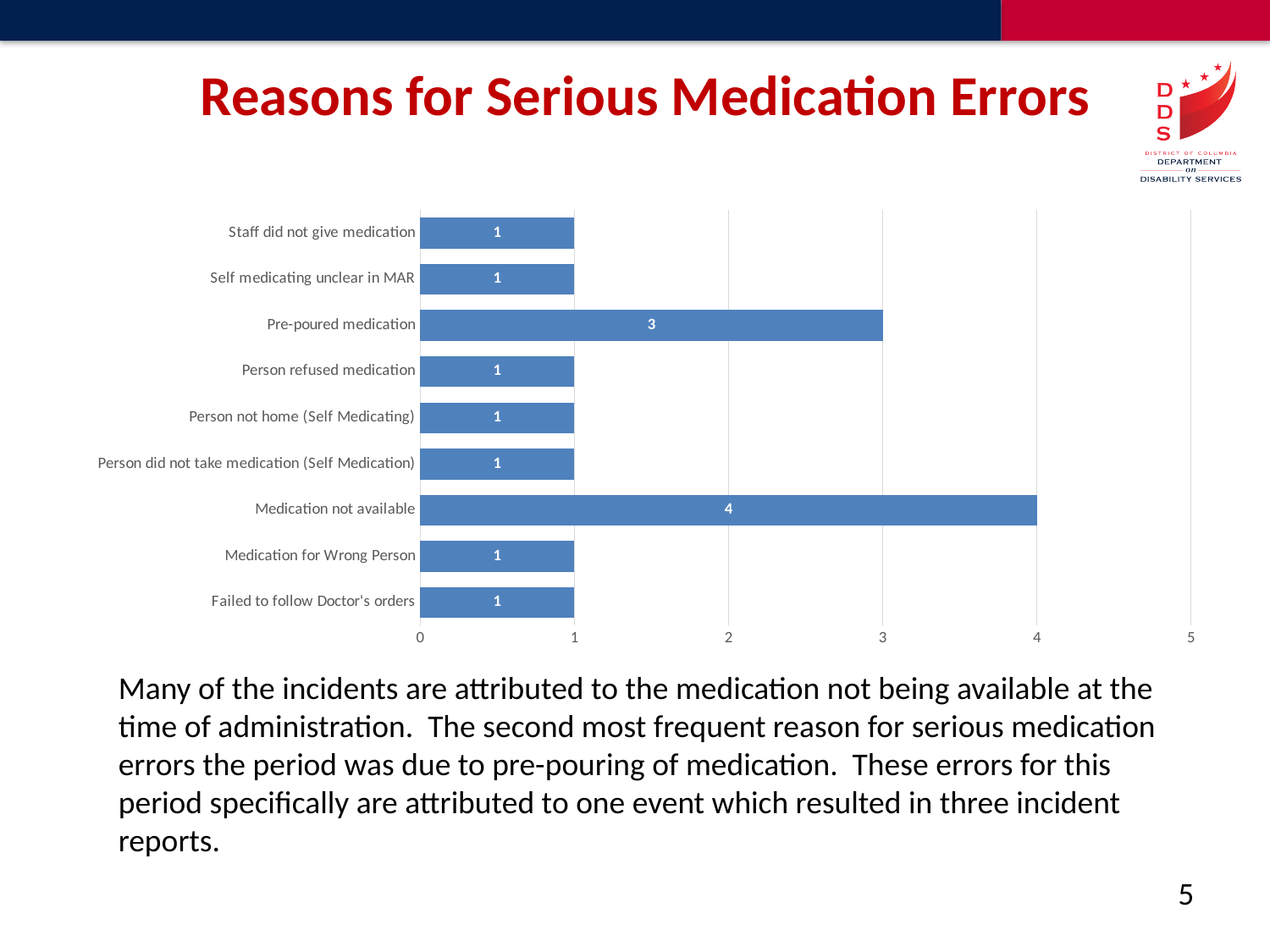
What is the total of all the values shown in the chart? 14 What kind of chart is shown on the slide? bar chart Is the value for Medication not available greater or less than 3? greater What is the value for Pre-poured medication? 3 What is the highest value shown on the x axis? 5 How many categories are shown in the chart? 9 What is the value for Medication not available? 4 Which is larger, the value for Pre-poured medication or the value for Person refused medication? Pre-poured medication What is the title of the slide containing the chart? Reasons for Serious Medication Errors What is the difference between the values for Medication not available and Pre-poured medication? 1 What is the value for Staff did not give medication? 1 Which category has the highest value? Medication not available